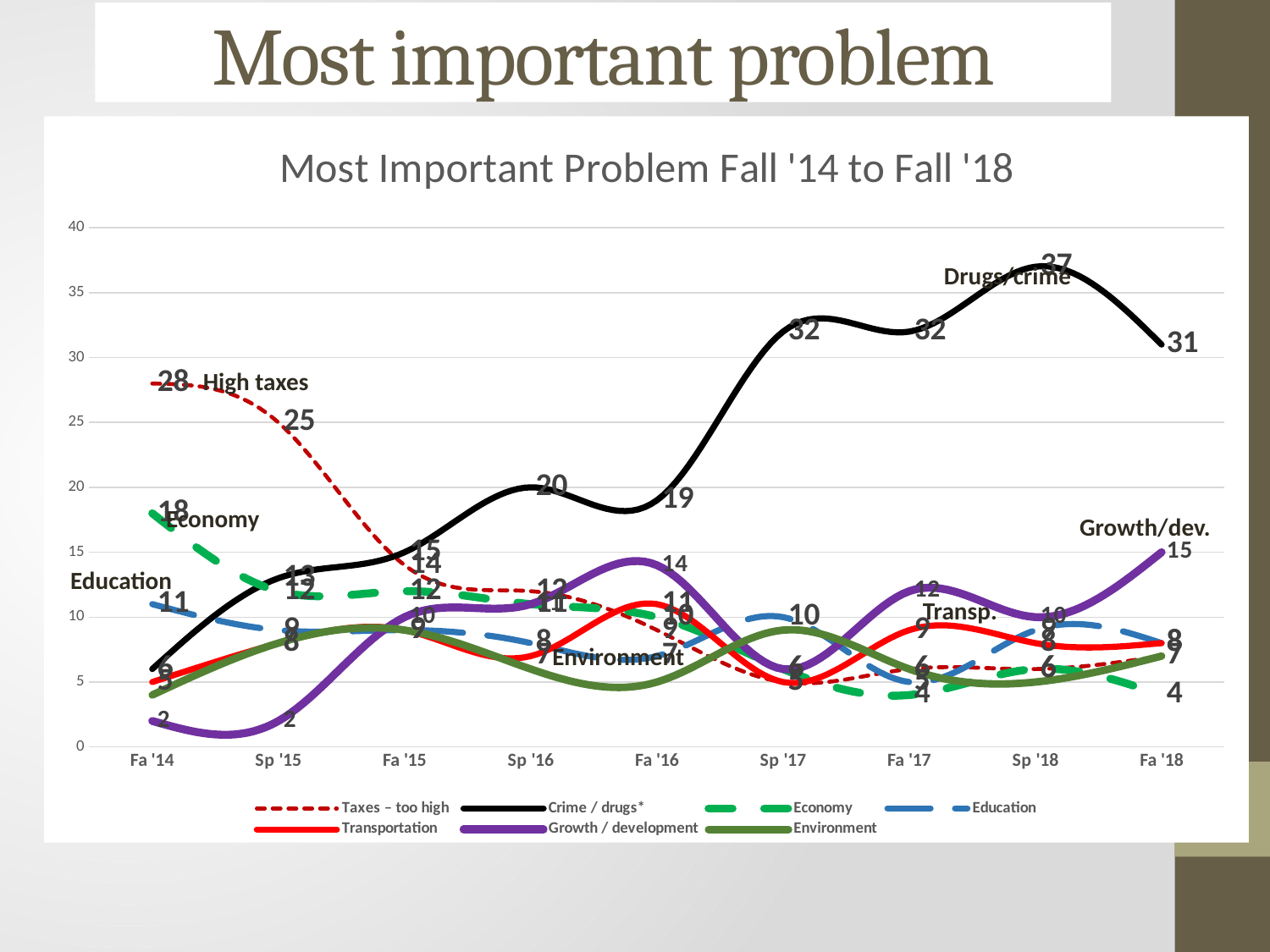
How many time points are shown along the x axis? 9 What is the value for Crime / drugs* at Fa '18? 31 What kind of chart is shown on the slide? line chart What is the difference between the Crime / drugs* values at Sp '18 and Fa '18? 6 What is the value for Crime / drugs* at Sp '18? 37 Which series has the highest value at Fa '14? Taxes – too high How many series does the legend list? 7 Is the value for Growth / development at Fa '14 greater or less than 5? less Which is larger at Fa '14: Taxes – too high or Economy? Taxes – too high What is the value for Taxes – too high at Fa '14? 28 What is the value for Growth / development at Fa '18? 15 Does the Taxes – too high series rise or fall from Fa '14 to Fa '18? fall